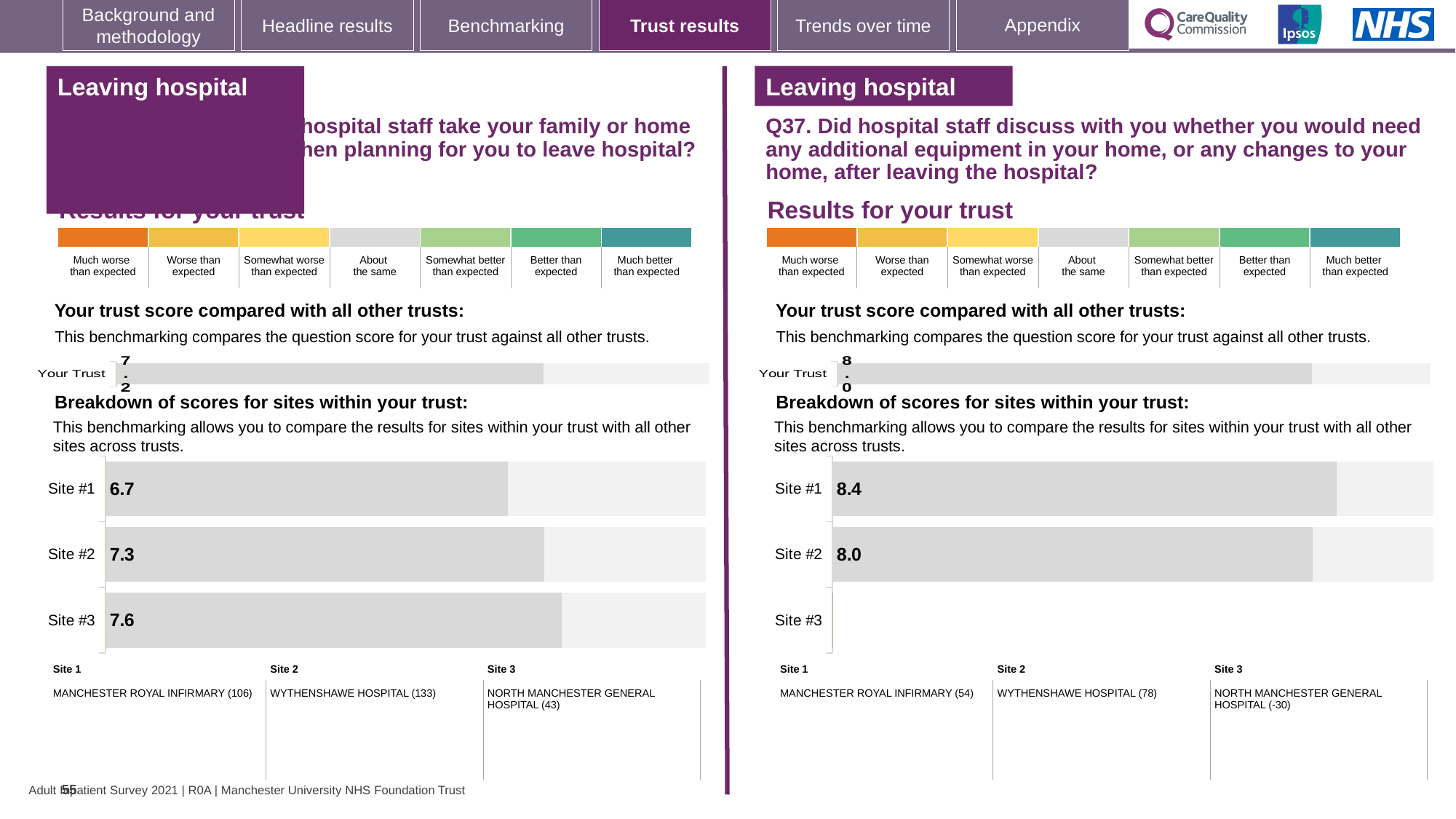
On the left-hand slide's site breakdown chart, which site has the highest score? Site #3 How many sites are listed in the site breakdown chart on the left-hand slide? 3 On the right-hand slide (Q37), what is the score for Site #2 in the site breakdown chart? 8.0 On the right-hand slide (Q37), what is the 'Your Trust' score shown in the trust comparison chart? 8.0 On the right-hand slide (Q37), which of Site #1 or Site #2 has the larger score? Site #1 On the left-hand slide's site breakdown chart, what is the score for Site #3? 7.6 What kind of chart is used for the site breakdown on the right-hand slide (Q37)? Bar chart On the left-hand slide's site breakdown chart, what is the difference between the scores for Site #3 and Site #1? 0.9 On the left-hand slide, what is the 'Your Trust' score shown in the trust comparison chart? 7.2 On the left-hand slide's site breakdown chart, what is the score for Site #1? 6.7 On the right-hand slide (Q37), what is the score for Site #1 in the site breakdown chart? 8.4 On the left-hand slide's site breakdown chart, which site has the lowest score? Site #1